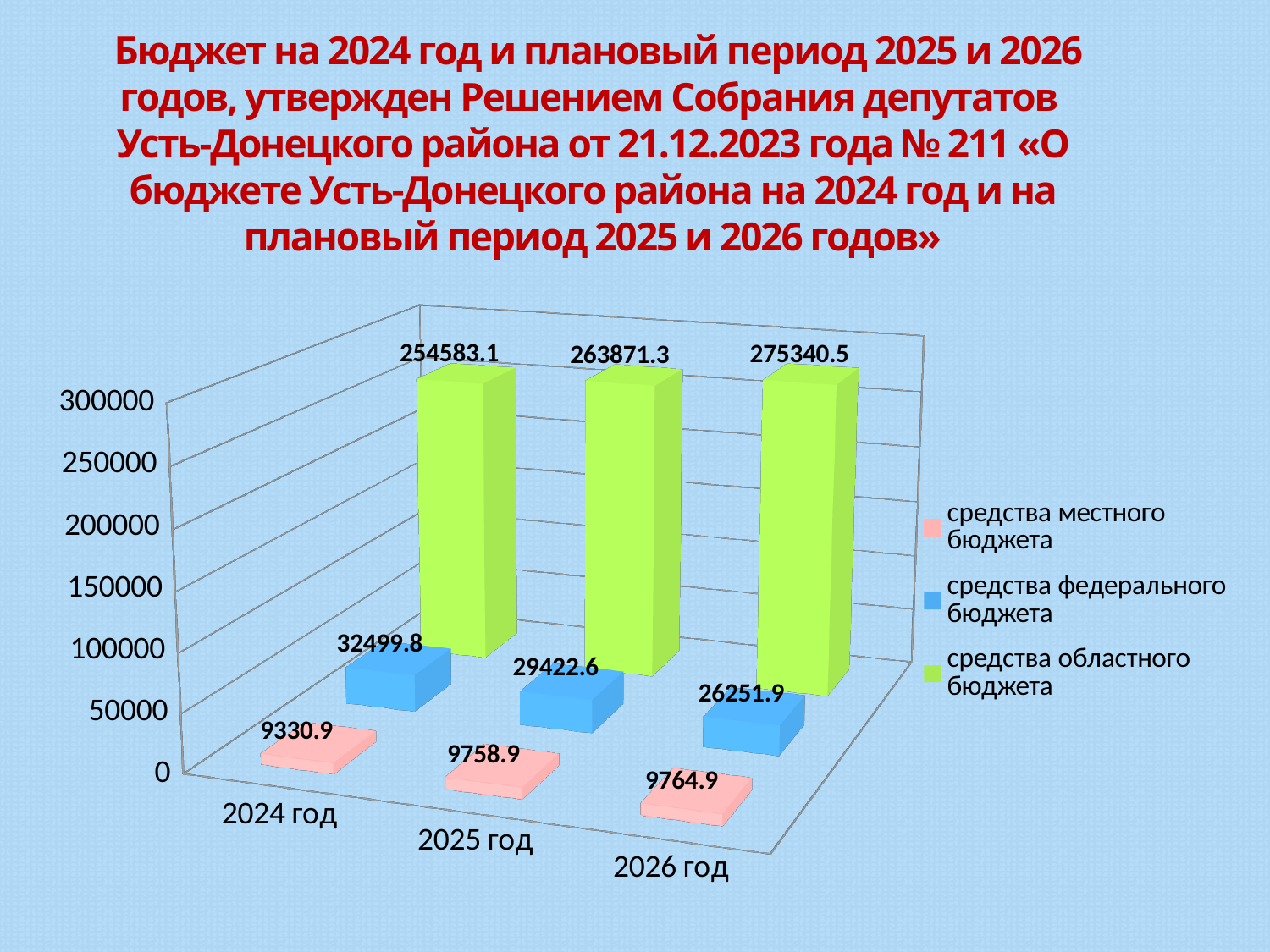
How many series does the legend list? 3 What is the difference between средства областного бюджета in 2026 год and in 2024 год? 20757.4 What is the value for средства местного бюджета in 2026 год? 9764.9 What is the value for средства федерального бюджета in 2025 год? 29422.6 Do the values for средства федерального бюджета rise or fall from 2024 год to 2026 год? fall In which year is средства федерального бюджета lowest? 2026 год In which year is средства областного бюджета highest? 2026 год How many years are shown on the x axis? 3 What is the difference between средства федерального бюджета in 2024 год and in 2026 год? 6247.9 What kind of chart is shown on the slide? bar chart What is the value for средства областного бюджета in 2024 год? 254583.1 Which is larger: средства федерального бюджета in 2024 год or in 2025 год? 2024 год